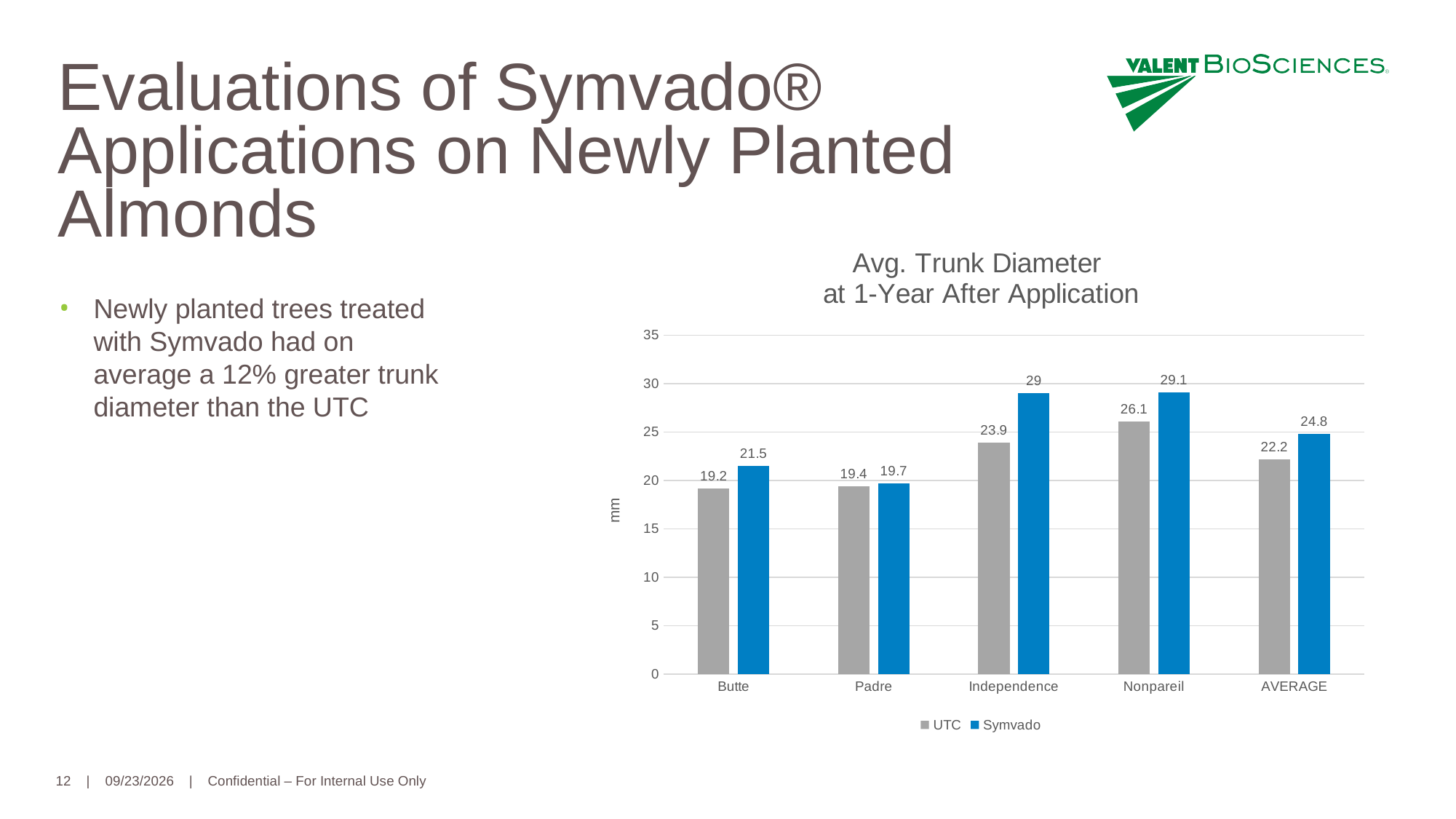
What is the Symvado value for AVERAGE? 24.8 What kind of chart is shown? bar chart How many series does the legend list? 2 What is the difference between the Symvado and UTC values for Nonpareil? 3 Which category has the lowest UTC value? Butte Which category has the highest Symvado value? Nonpareil How many categories are shown on the x axis? 5 What is the UTC value for Butte? 19.2 Which is larger for Padre, the UTC value or the Symvado value? Symvado What is the title of the chart? Avg. Trunk Diameter at 1-Year After Application What is the Symvado value for Independence? 29 Is the UTC value for Independence greater or less than 25? less